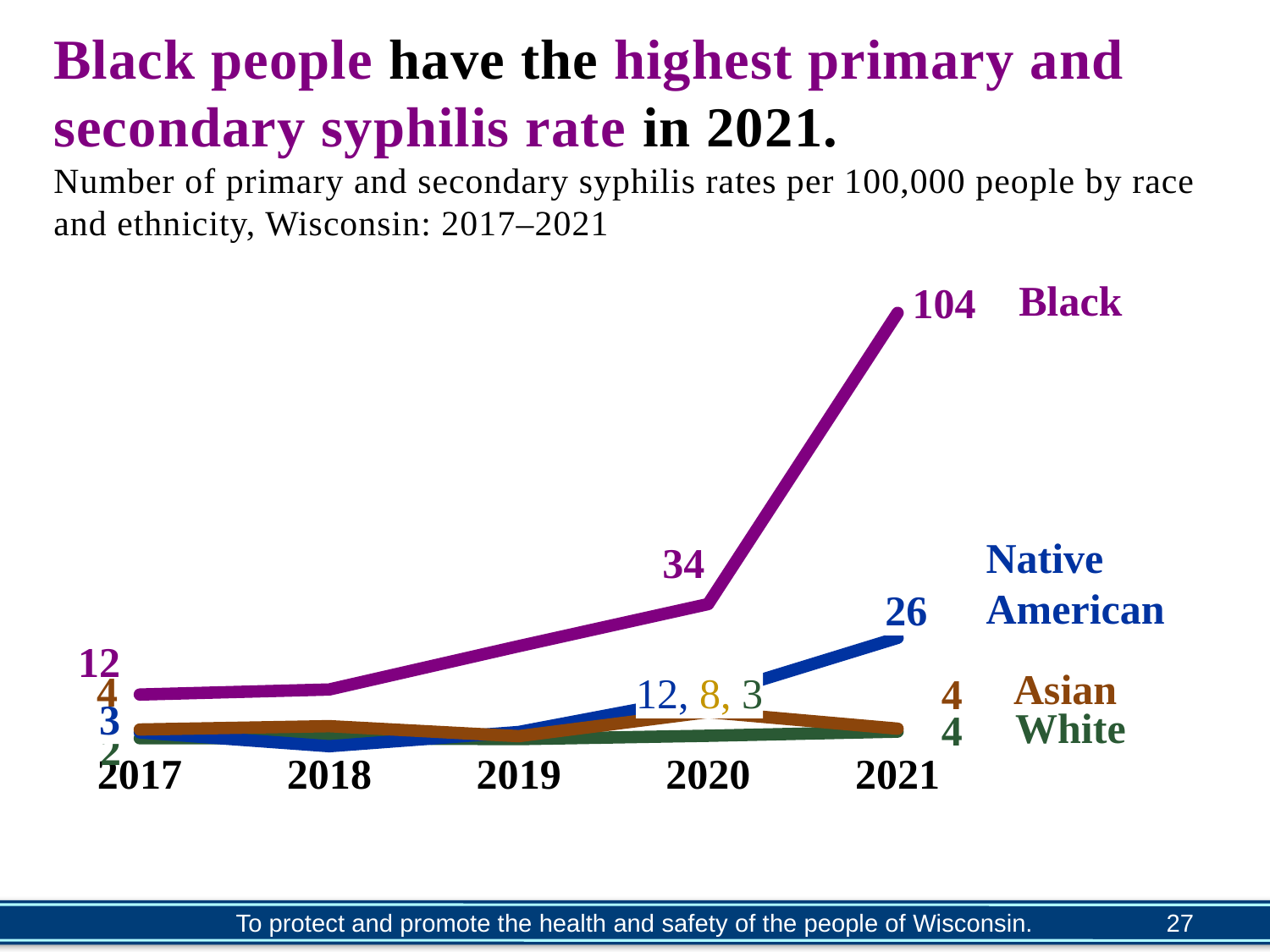
Which race or ethnicity group has the highest rate in 2021? Black Which is larger in 2021, the rate for Native American people or for Asian people? Native American By how much did the rate for Black people increase from 2020 to 2021? 70 What is the rate for Black people in 2020? 34 What is the difference between the Black and Native American rates in 2021? 78 What is the rate for Asian people in 2021? 4 What is the rate for Black people in 2017? 12 How many race and ethnicity groups are plotted as lines? 4 What is the primary and secondary syphilis rate for Black people in 2021? 104 What type of chart is shown on the slide? line chart What is the rate for Native American people in 2021? 26 How many years are shown on the x axis? 5